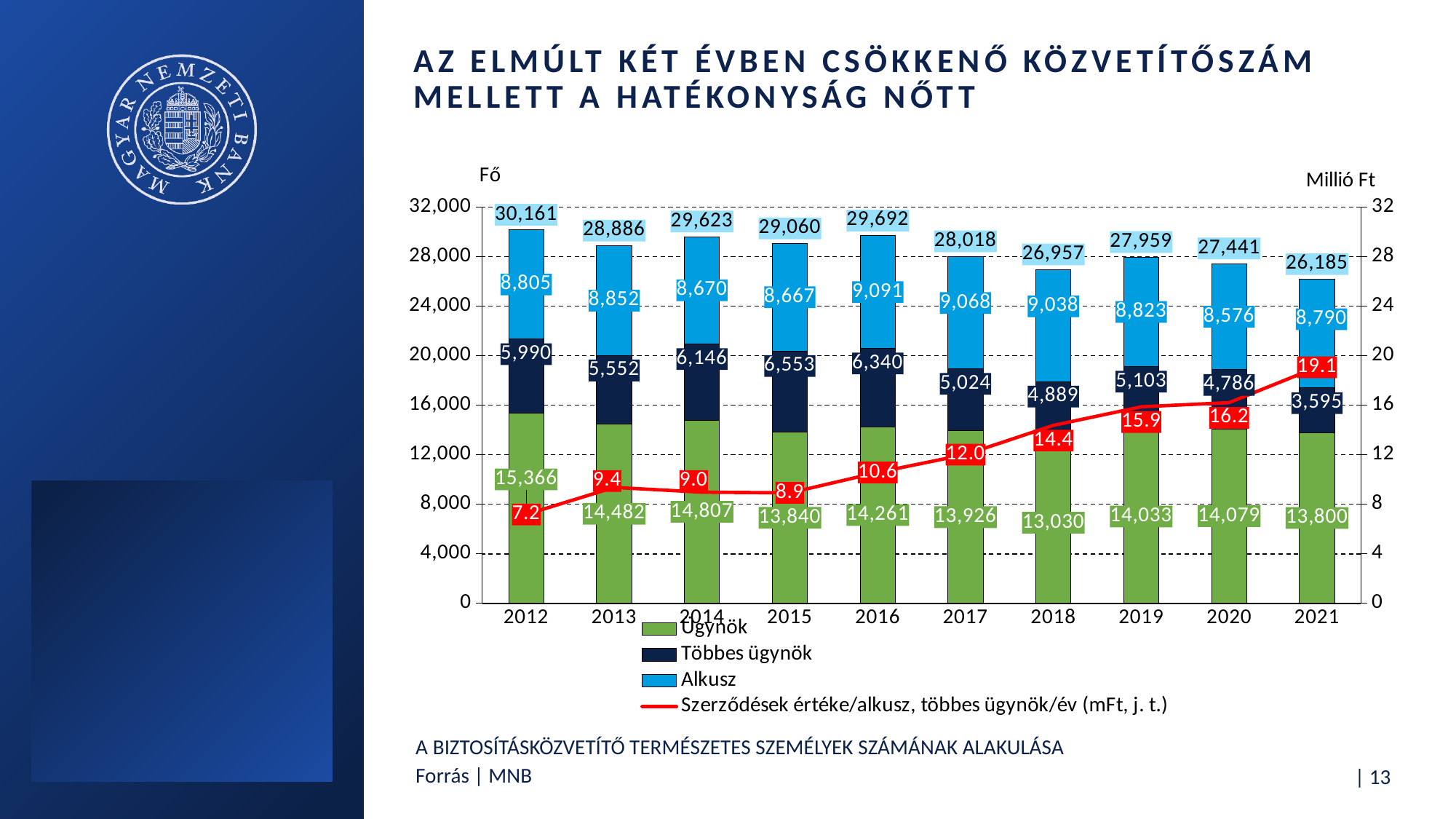
What is the value for Többes ügynök in 2021? 3,595 Which year has the lowest value for Többes ügynök? 2021 How many series does the legend list? 4 Which year has the highest stacked bar total? 2012 What is the total of the stacked bar for 2018? 26,957 What is the difference between the Ügynök values for 2012 and 2013? 884 Which is larger, the Alkusz value in 2013 or in 2020? 2013 What is the value for Alkusz in 2016? 9,091 What is the value of the red line (Szerződések értéke/alkusz, többes ügynök/év) in 2020? 16.2 Does the red line (Szerződések értéke/alkusz, többes ügynök/év) generally rise or fall from 2012 to 2021? rise What is the value for Ügynök in 2012? 15,366 How many years are shown on the x axis? 10